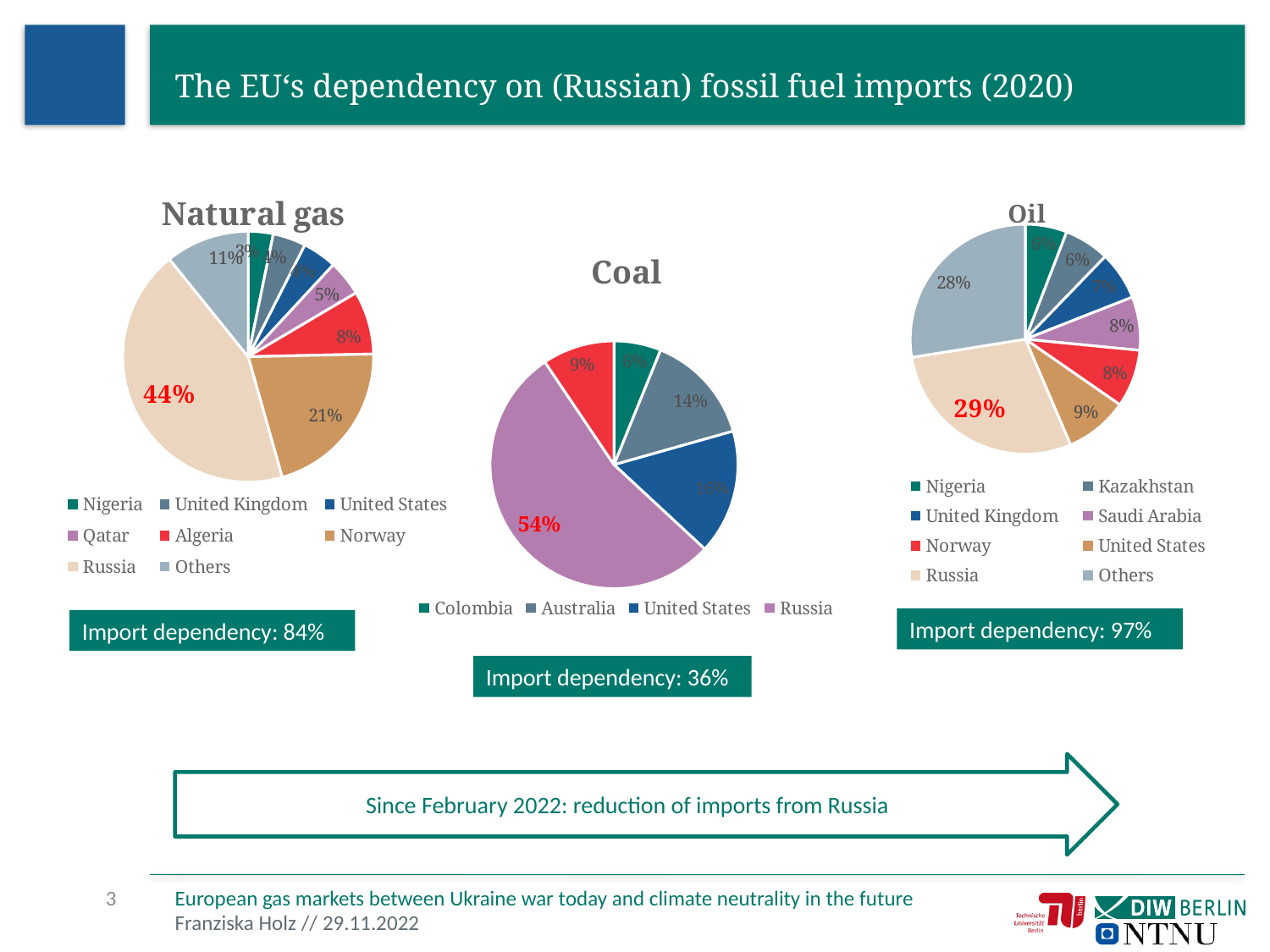
In the Oil pie chart, what share does the United States account for? 9% In the Coal pie chart, what share does Russia account for? 54% In the Natural gas pie chart, which is larger, the Norway slice or the Algeria slice? Norway How many categories does the legend of the Natural gas chart list? 8 In the Natural gas pie chart, what is the difference between the Russia share and the Norway share? 23% In the Coal pie chart, what share does Australia account for? 14% In the Natural gas pie chart, what share does Russia account for? 44% In the Oil pie chart, what share does Others account for? 28% In the Natural gas pie chart, what share does Norway account for? 21% What kind of chart is used for the Oil data? Pie chart In the Oil pie chart, what share does Russia account for? 29% In the Natural gas pie chart, which country has the largest slice? Russia